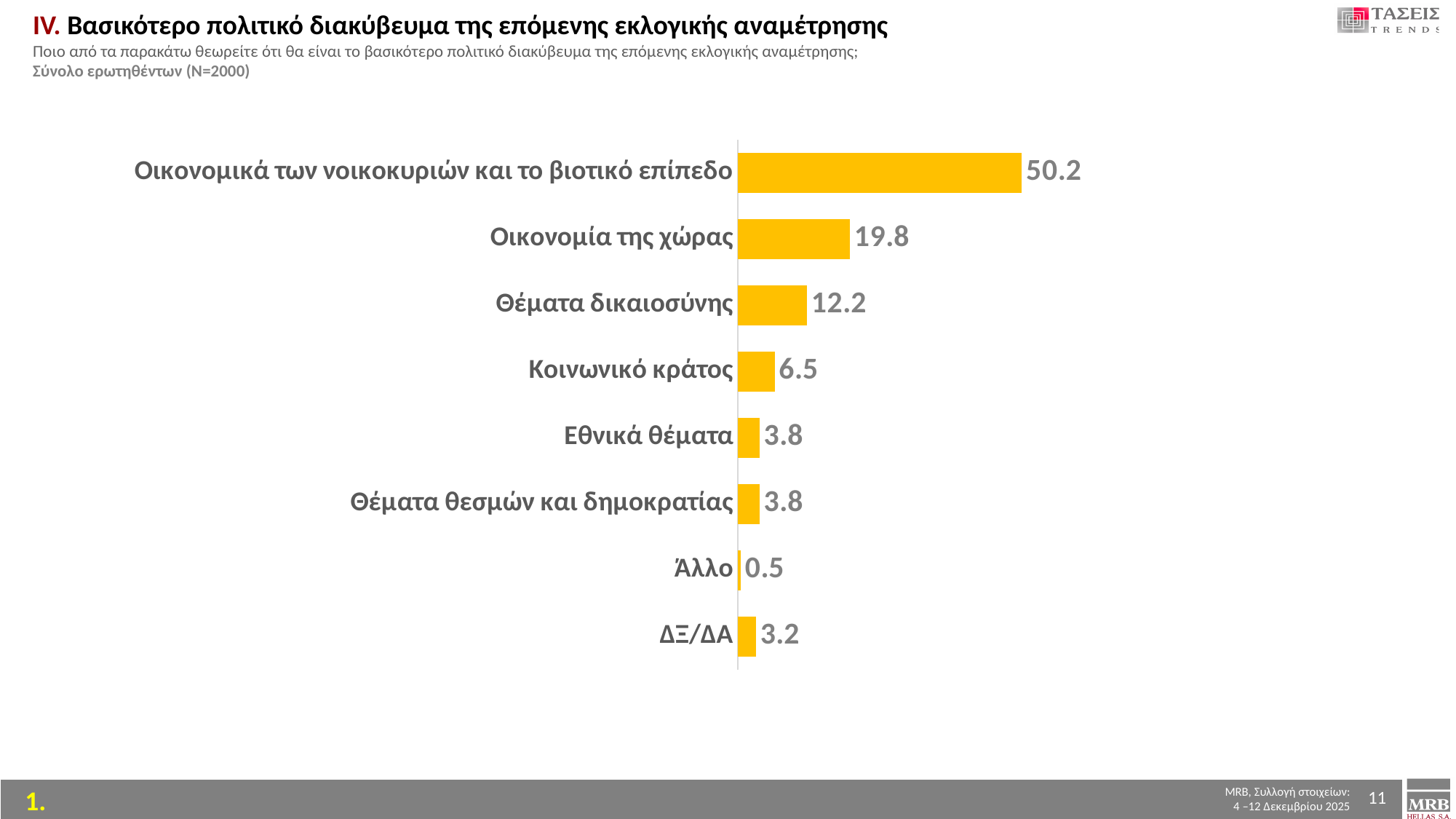
Which is larger, the value for Θέματα δικαιοσύνης or the value for Κοινωνικό κράτος? Θέματα δικαιοσύνης Which category has the lowest value? Άλλο What is the value for Οικονομικά των νοικοκυριών και το βιοτικό επίπεδο? 50.2 What colour are the bars in the chart? Yellow How many categories are shown in the chart? 8 What is the value for ΔΞ/ΔΑ? 3.2 What is the difference between the values for Κοινωνικό κράτος and Εθνικά θέματα? 2.7 Which category has the highest value? Οικονομικά των νοικοκυριών και το βιοτικό επίπεδο What is the difference between the values for Οικονομικά των νοικοκυριών και το βιοτικό επίπεδο and Οικονομία της χώρας? 30.4 What is the value for Οικονομία της χώρας? 19.8 What is the value for Θέματα δικαιοσύνης? 12.2 What kind of chart is shown on the slide? Bar chart